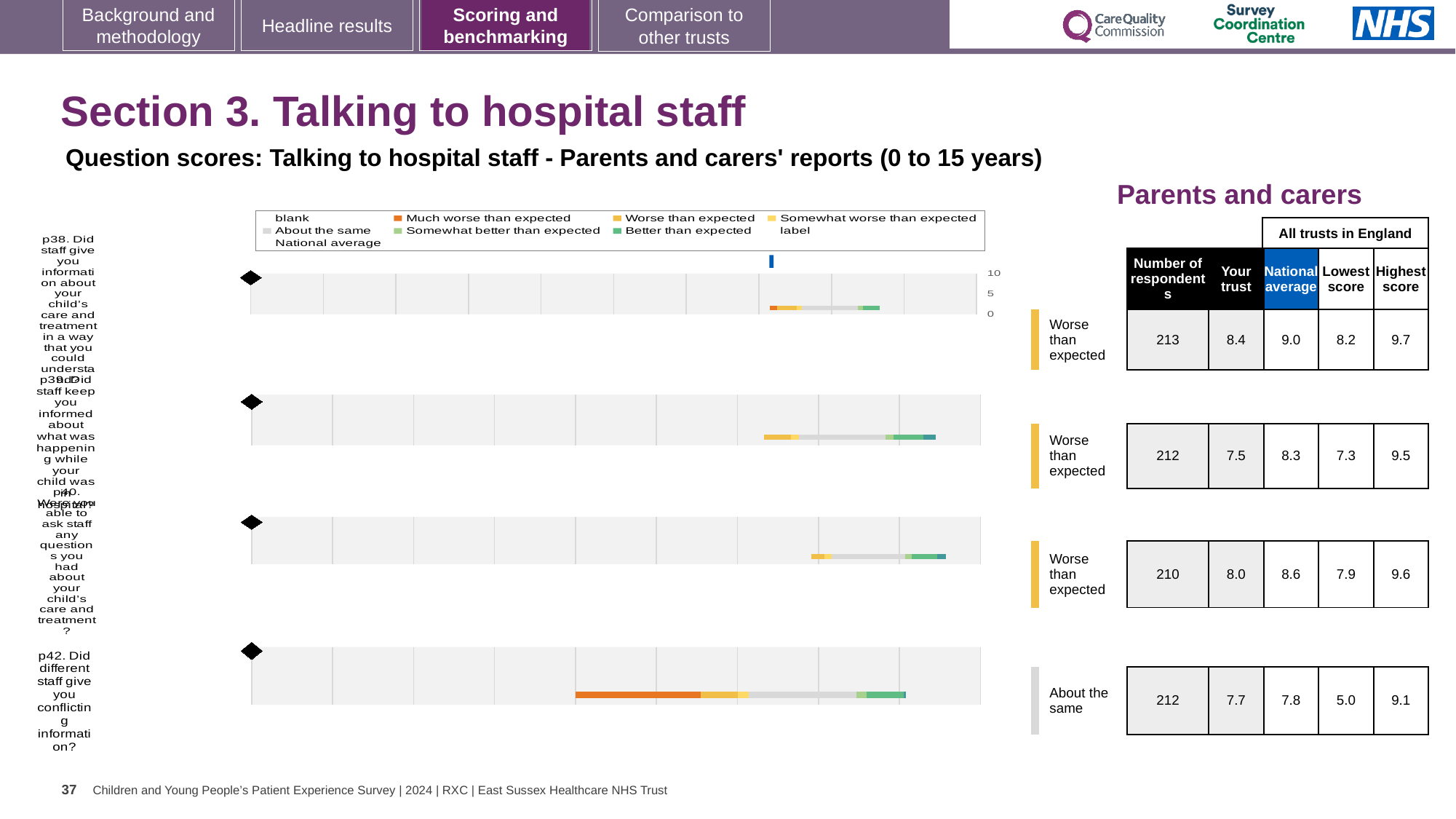
For the fourth chart (p42), which is larger: the 'Your trust' score or the National average? National average For the first chart (p38, staff giving information about your child's care and treatment), what is the 'Your trust' score shown in the table? 8.4 For the fourth chart (p42), what is the Lowest score among all trusts in England? 5.0 In the legend, what colour represents 'Much worse than expected'? orange What benchmark category label is shown next to the fourth chart (p42)? About the same For the first chart (p38), what is the difference between the National average and the 'Your trust' score? 0.6 Which question row has the lowest 'Your trust' score? p39 For the fourth chart (p42, different staff giving conflicting information), what is the National average score? 7.8 For the third chart (p40), how many respondents are shown in the table? 210 What kind of chart is used for the four question rows on this slide? bar chart Which question row has the highest 'Your trust' score? p38 How many separate bar charts (one per question) are shown on the slide? 4